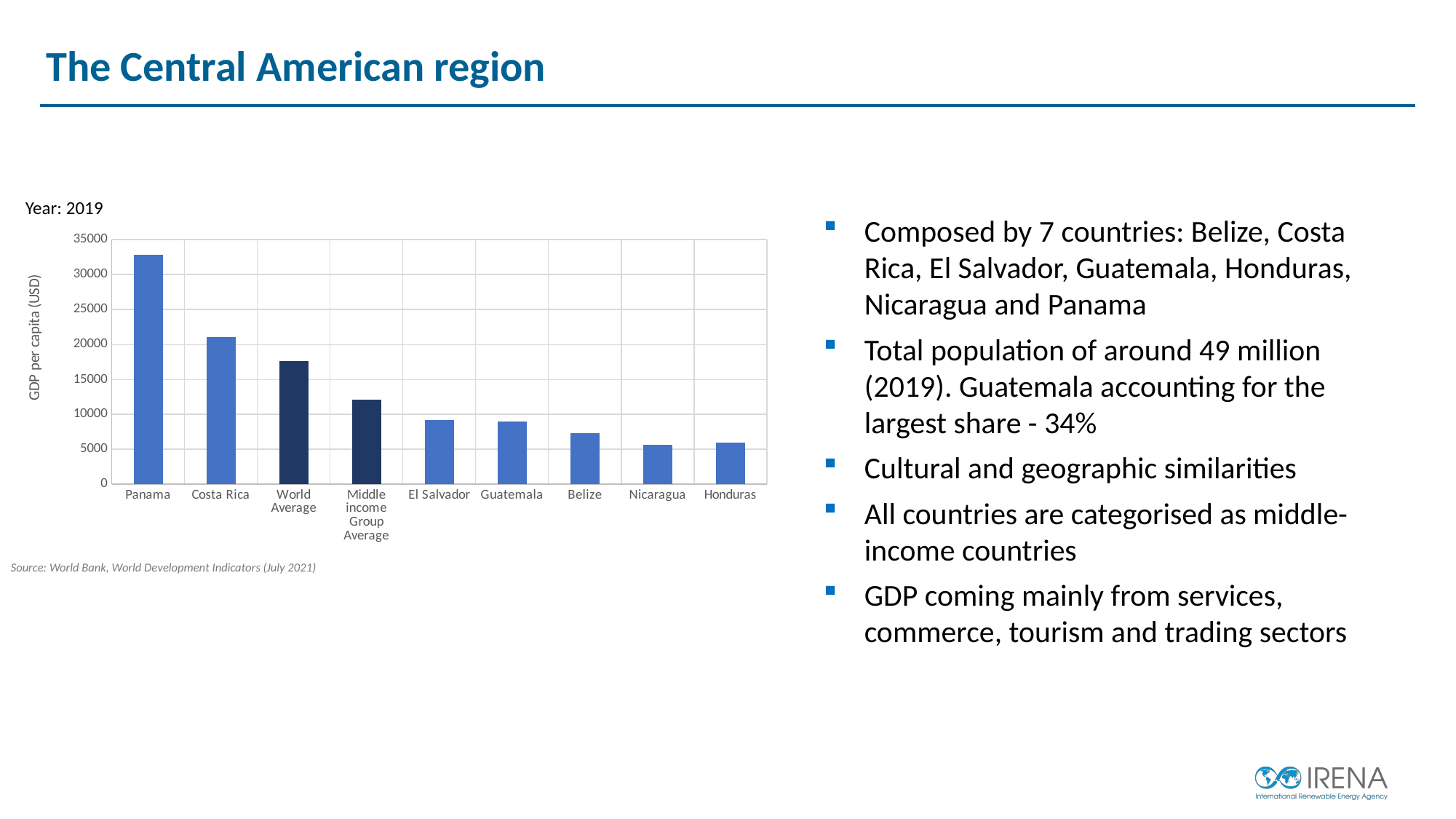
Which category has the highest GDP per capita on the chart? Panama Is the value for Honduras greater or less than 10000? less Is the value for World Average greater or less than 20000? less Is the value for El Salvador greater or less than 10000? less What kind of chart is shown on the slide? bar chart What is the label on the vertical axis of the chart? GDP per capita (USD) How many categories are plotted on the chart? 9 Which is larger, the value for Belize or the value for Nicaragua? Belize Which is larger, the value for Panama or the value for Costa Rica? Panama